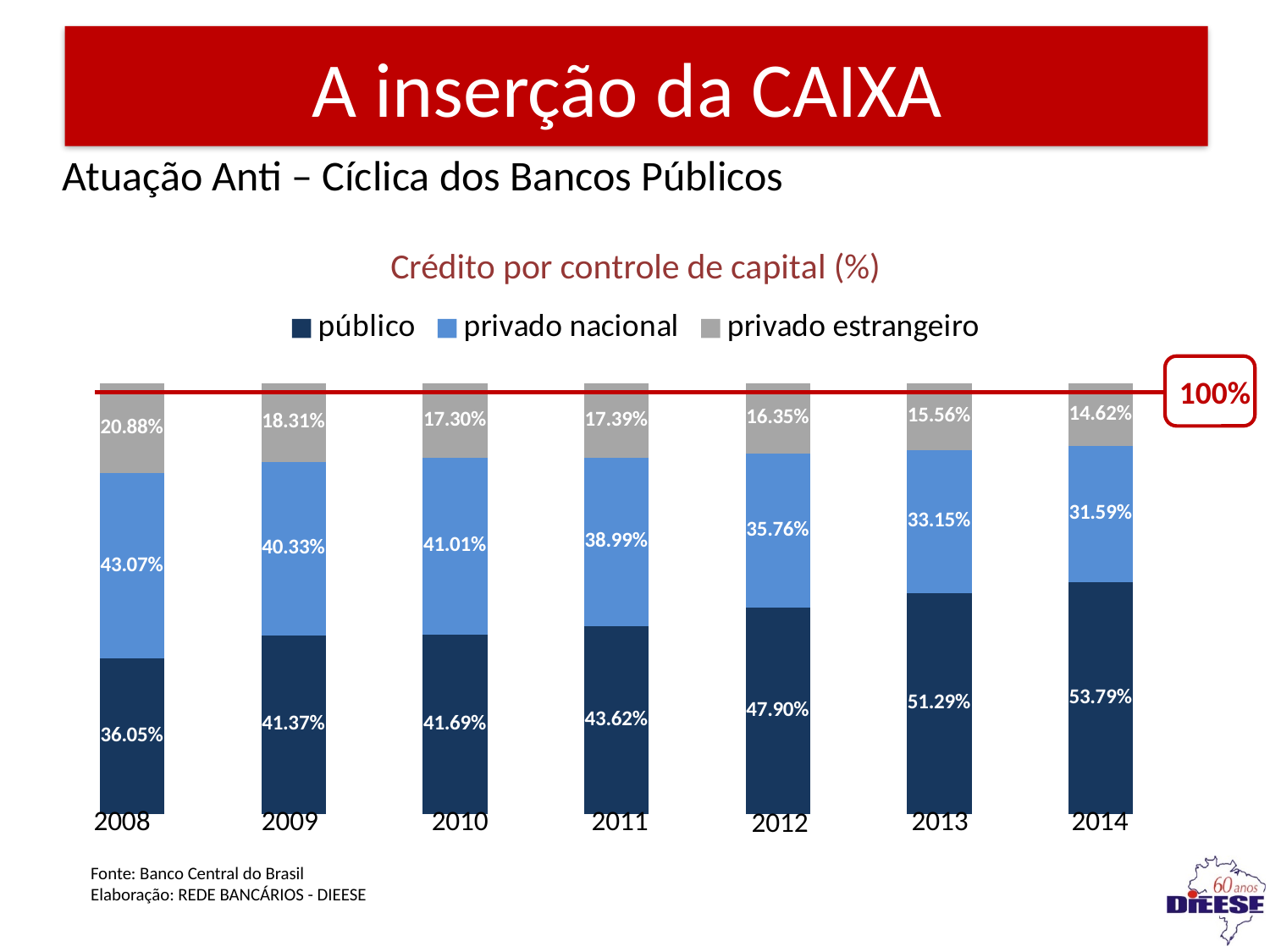
What is the value for privado nacional in 2011? 38.99% How many years are shown on the x axis? 7 In which year is the público share highest? 2014 What kind of chart is shown? stacked bar chart What is the value for privado estrangeiro in 2008? 20.88% What is the value for público in 2014? 53.79% In which year is the privado estrangeiro share lowest? 2014 Which is larger in 2008, público or privado nacional? privado nacional What is the difference between the público values in 2014 and 2008? 17.74% What is the total of the stacked bar for 2008? 100% How many series does the legend list? 3 Does the público share rise or fall from 2008 to 2014? rise